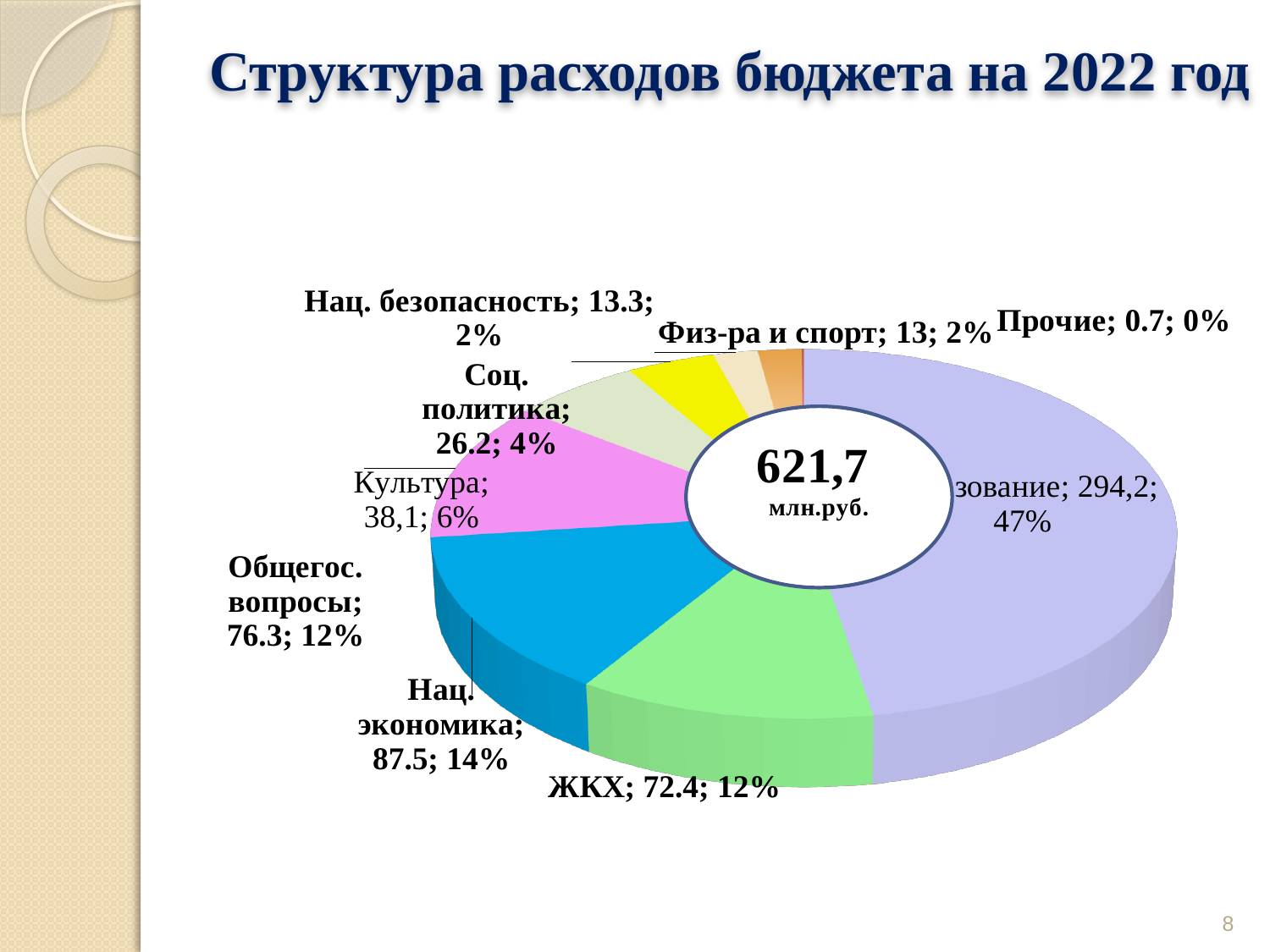
What share of the pie does Культура have? 6% Which is larger, Нац. экономика or Общегос. вопросы? Нац. экономика Which category has the smallest slice of the pie? Прочие What share of the pie does the largest slice have? 47% What is the title of the chart? Структура расходов бюджета на 2022 год What value is shown for Общегос. вопросы? 76.3 What share of the pie does Нац. экономика have? 14% How many slices does the pie chart have? 9 What value is shown for ЖКХ? 72.4 What value is shown for Соц. политика? 26.2 What kind of chart is shown on the slide? pie chart What total value is shown in the centre of the pie chart? 621,7 млн.руб.